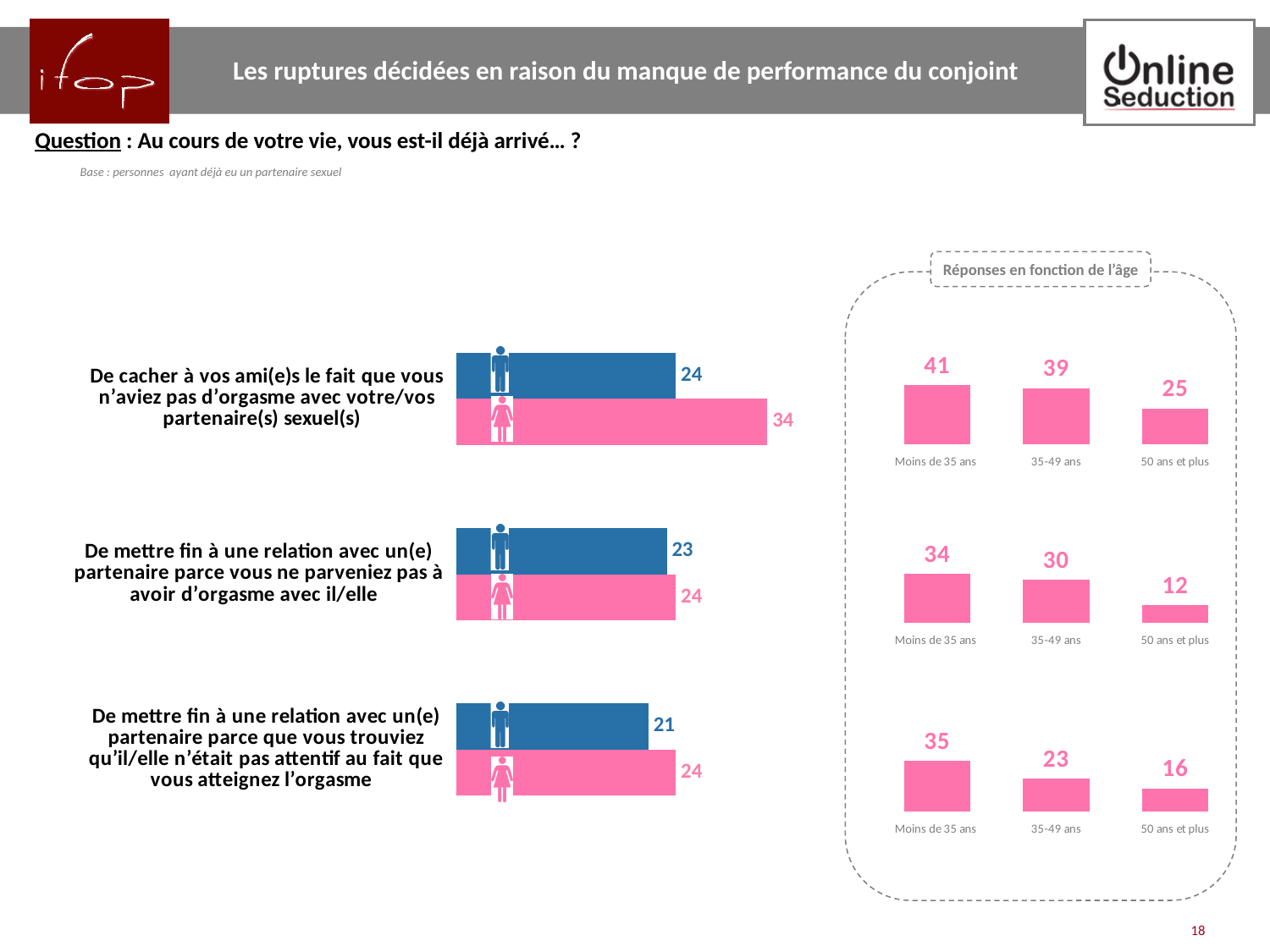
In the left-hand bar chart for 'De cacher à vos ami(e)s le fait que vous n'aviez pas d'orgasme avec votre/vos partenaire(s) sexuel(s)', what is the value for women (pink bar)? 34 In the top right-hand age chart (Réponses en fonction de l'âge, first row), what is the value for 'Moins de 35 ans'? 41 In the left-hand bar chart for 'De cacher à vos ami(e)s le fait que vous n'aviez pas d'orgasme', what is the difference between the women's value and the men's value? 10 In the top right-hand age chart (first row), which age group has the lowest value? 50 ans et plus How many age categories are shown in each right-hand age chart? 3 In the bottom right-hand age chart (third row), which age group has the highest value? Moins de 35 ans In the left-hand bar chart for 'De cacher à vos ami(e)s le fait que vous n'aviez pas d'orgasme avec votre/vos partenaire(s) sexuel(s)', what is the value for men (blue bar)? 24 In the middle right-hand age chart (second row), what is the value for '50 ans et plus'? 12 In the bottom right-hand age chart (third row), do the values rise or fall from 'Moins de 35 ans' to '50 ans et plus'? fall In the left-hand bar chart for 'De mettre fin à une relation avec un(e) partenaire parce vous ne parveniez pas à avoir d'orgasme avec il/elle', what is the value for men? 23 In the left-hand bar chart for 'De mettre fin à une relation avec un(e) partenaire parce que vous trouviez qu'il/elle n'était pas attentif au fait que vous atteigniez l'orgasme', which is larger, the men's value or the women's value? women's value In the middle right-hand age chart (second row), what is the difference between 'Moins de 35 ans' and '35-49 ans'? 4